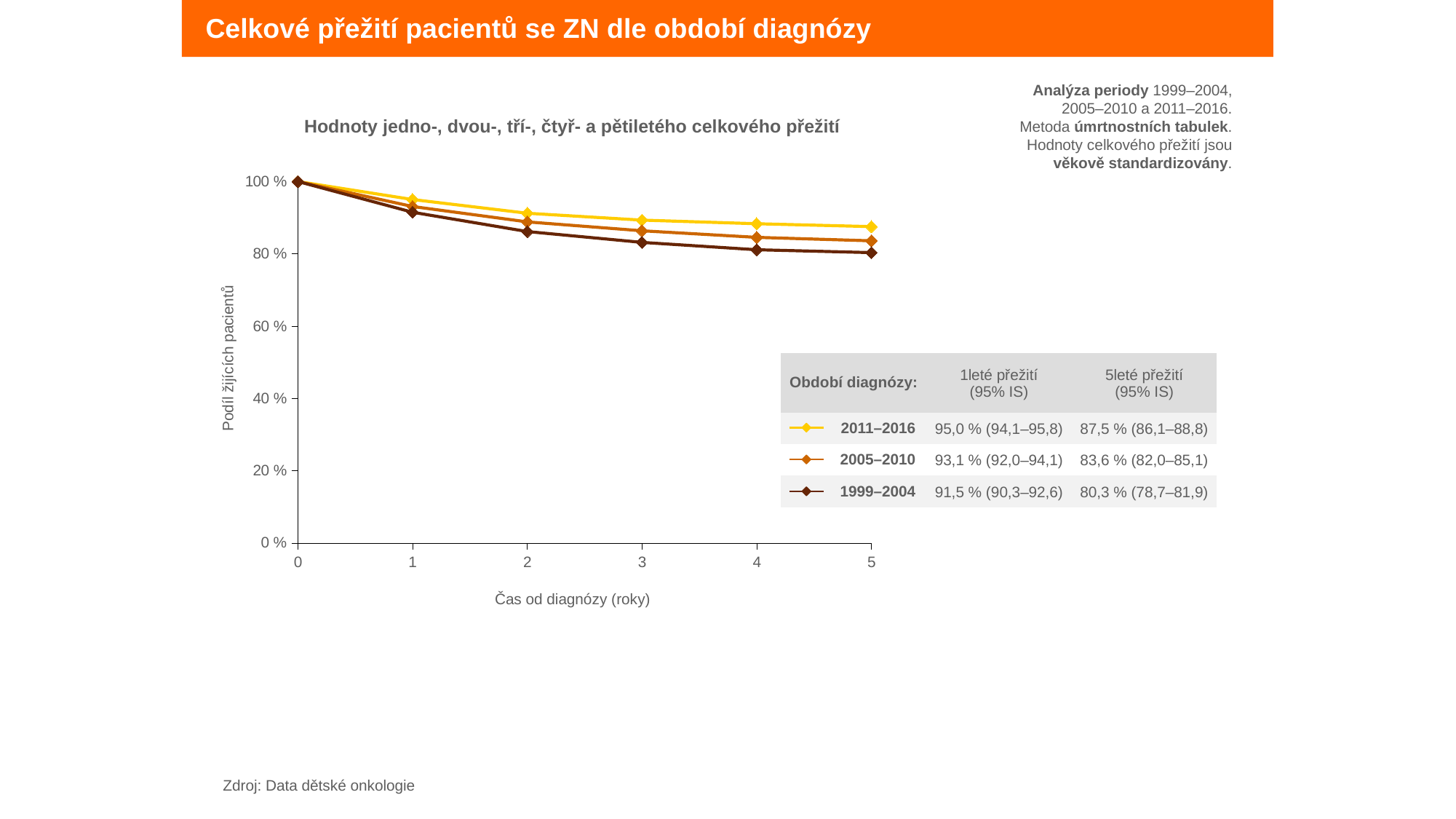
Which diagnosis period has the highest 5-year survival? 2011–2016 How many series does the legend list? 3 What is the label of the y axis? Podíl žijících pacientů What is the 1-year survival (1leté přežití) for the 2005–2010 period? 93,1 % Is the 5-year survival for the 2005–2010 period greater or less than 80 %? greater Do the survival values rise or fall as time from diagnosis increases? fall What kind of chart is shown on the slide? line chart Which diagnosis period has the lowest 1-year survival? 1999–2004 What is the 5-year survival (5leté přežití) for the 1999–2004 period? 80,3 % What is the difference between the 5-year survival of the 2011–2016 period and the 1999–2004 period? 7,2 % What is the 1-year survival (1leté přežití) for the 1999–2004 period? 91,5 % What is the 5-year survival (5leté přežití) for the 2011–2016 period? 87,5 %